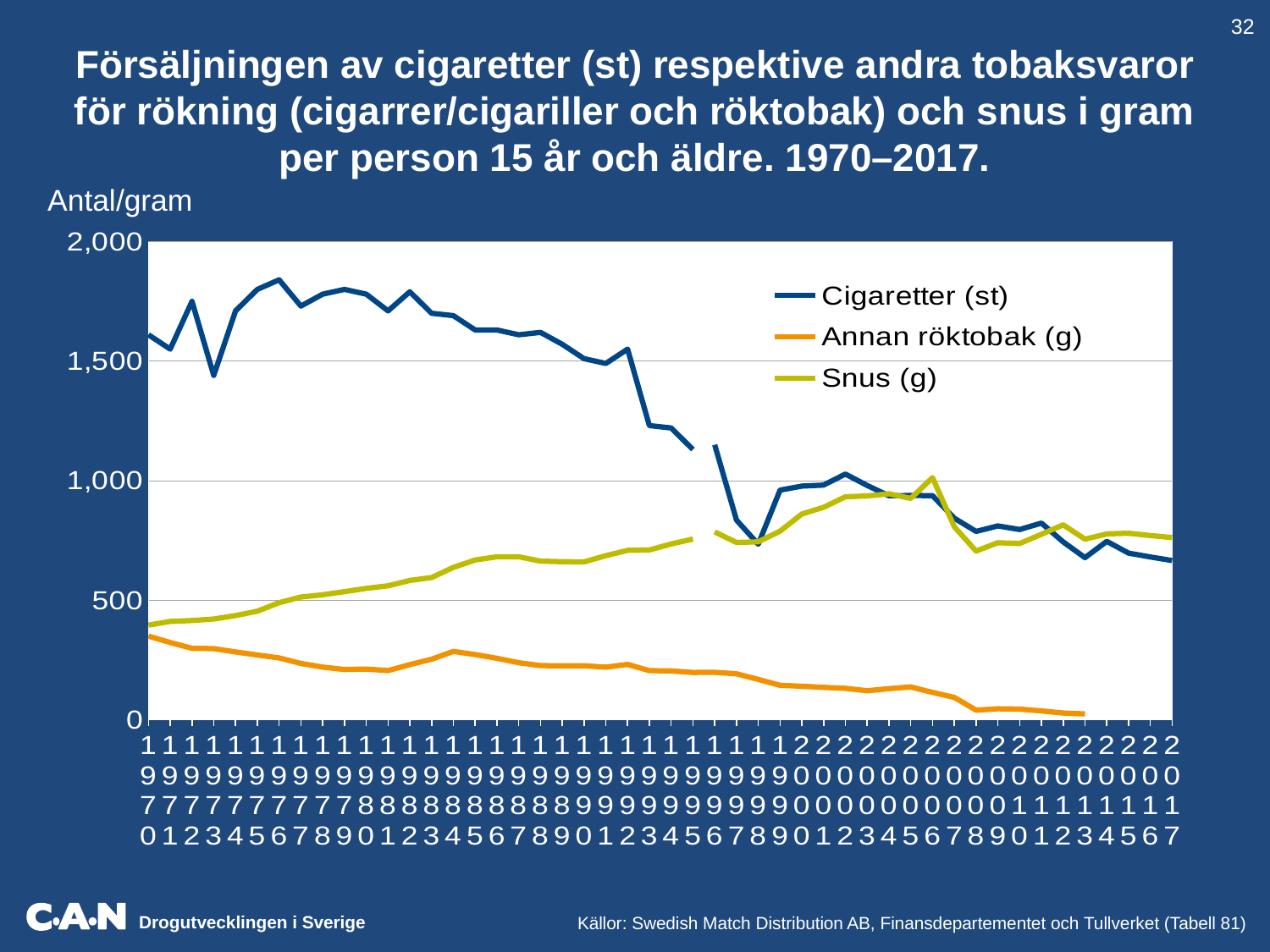
Which is larger in 2017, Snus (g) or Cigaretter (st)? Snus (g) How many series does the legend list? 3 Is the value for Snus (g) in 1970 greater or less than 500? less Does the Cigaretter (st) line generally rise or fall from 1970 to 2017? Fall Does the Snus (g) line generally rise or fall from 1970 to 2017? Rise Is the value for Cigaretter (st) in 1970 greater or less than 1,500? greater Which series has the highest value in 1970? Cigaretter (st) Which series does the orange line represent? Annan röktobak (g) Which series has the lowest value in 2010? Annan röktobak (g) What kind of chart is shown on the slide? Line chart Is the value for Cigaretter (st) in 2017 greater or less than 1,000? less What is the label shown above the vertical axis? Antal/gram